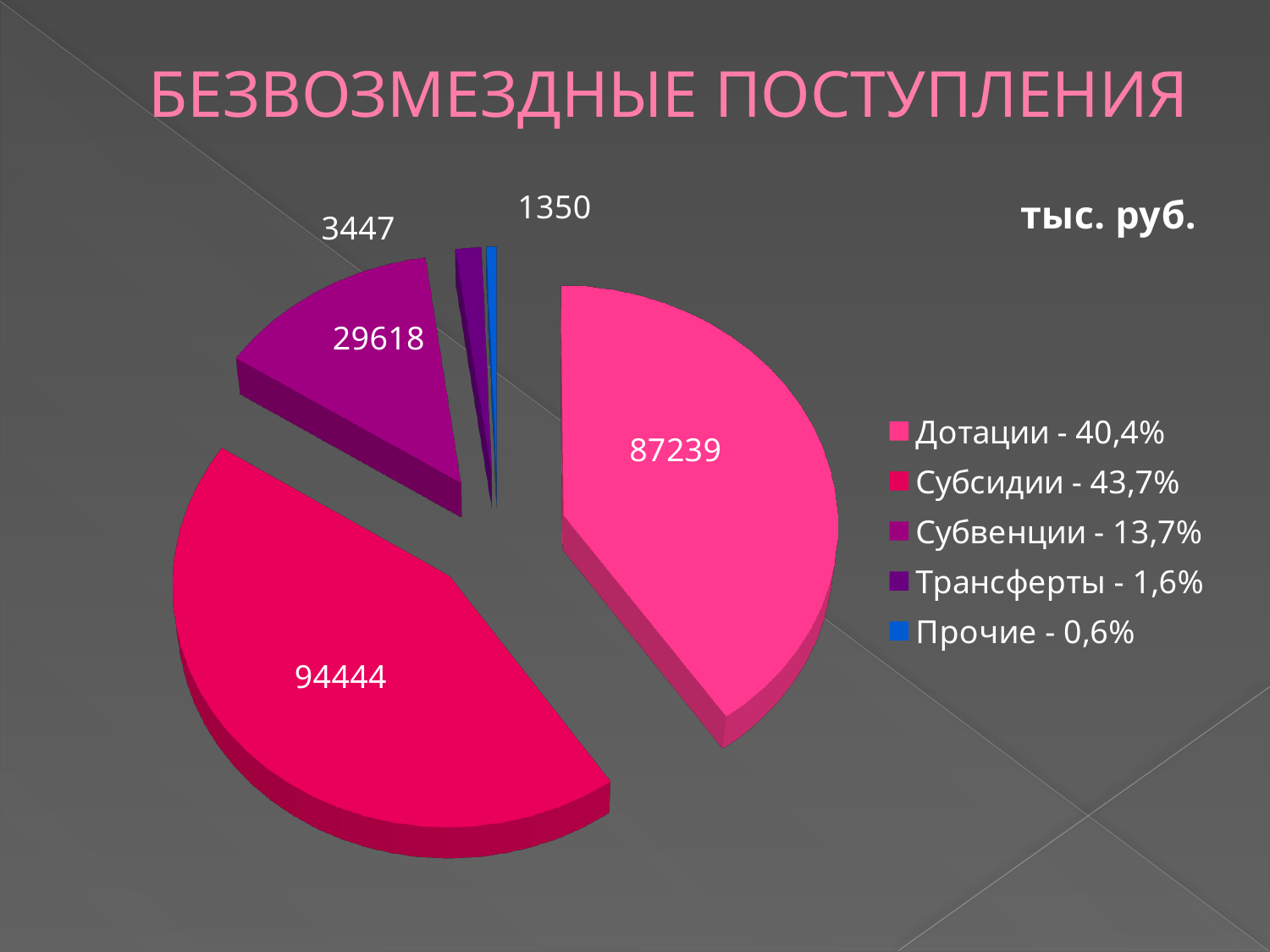
What is the value for Дотации? 87239 What is the difference between the values for Субсидии and Дотации? 7205 What kind of chart is shown on the slide? pie chart Which is larger, the value for Субвенции or the value for Трансферты? Субвенции How many categories does the pie chart show? 5 Which category has the smallest slice of the pie? Прочие What is the value for Субвенции? 29618 Which category has the largest slice of the pie? Субсидии What is the value for Субсидии? 94444 What is the value for Трансферты? 3447 What share of the pie does Субвенции represent, according to the legend? 13,7% What is the value for Прочие? 1350